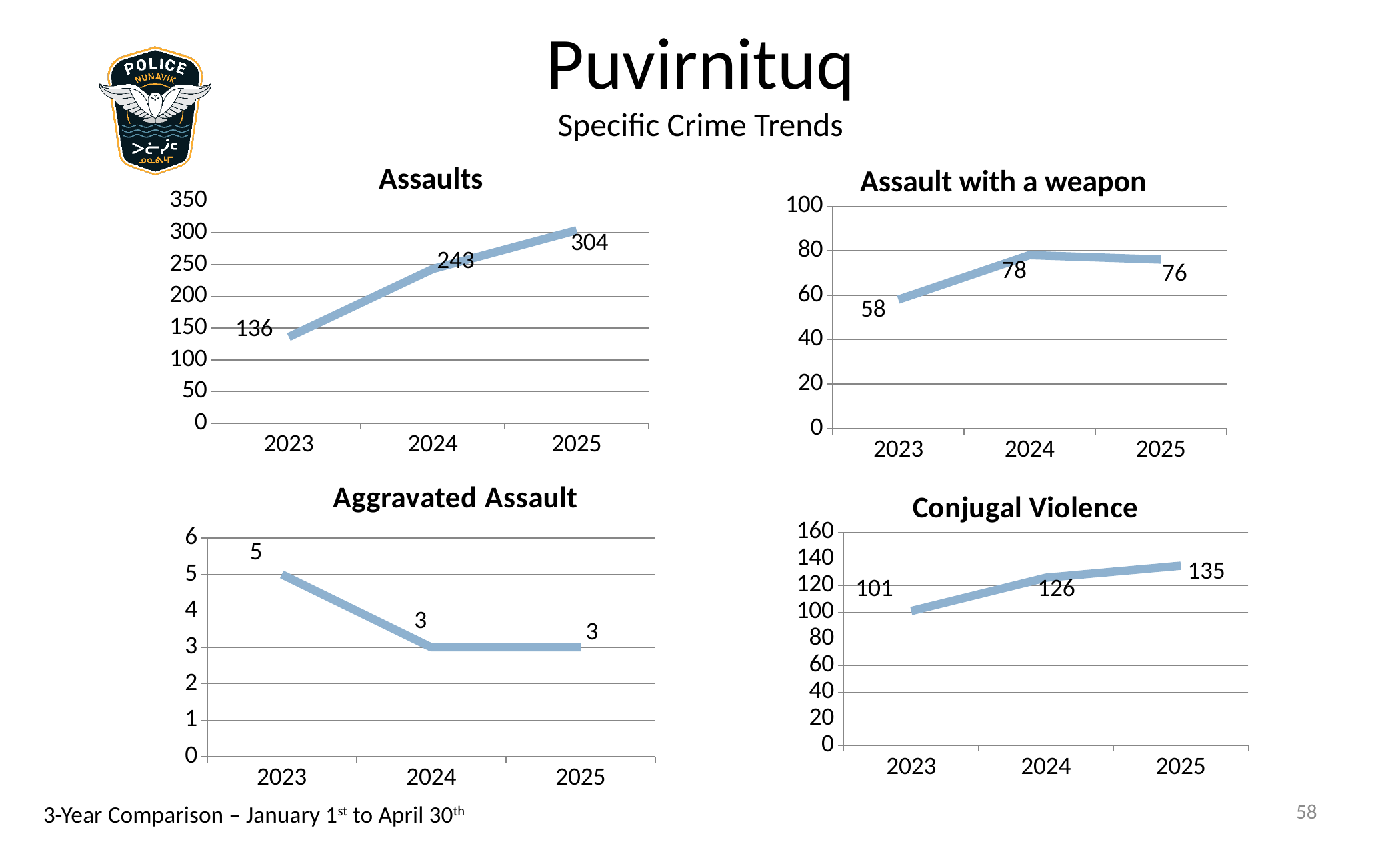
In the Aggravated Assault chart, what is the value for 2023? 5 In the Conjugal Violence chart, what is the value for 2024? 126 In the Assaults chart, do the values rise or fall from 2023 to 2025? rise In the Assault with a weapon chart, is the value for 2024 greater or less than 60? greater In the Aggravated Assault chart, which year has the highest value? 2023 In the Assault with a weapon chart, which year has the highest value? 2024 In the Assaults chart, what is the difference between the 2025 and 2023 values? 168 In the Assault with a weapon chart, what is the value for 2023? 58 In the Conjugal Violence chart, which is larger, the value for 2023 or the value for 2025? 2025 How many years are plotted in the Conjugal Violence chart? 3 What kind of chart is the Assaults chart? line chart In the Assaults chart, what is the value for 2025? 304